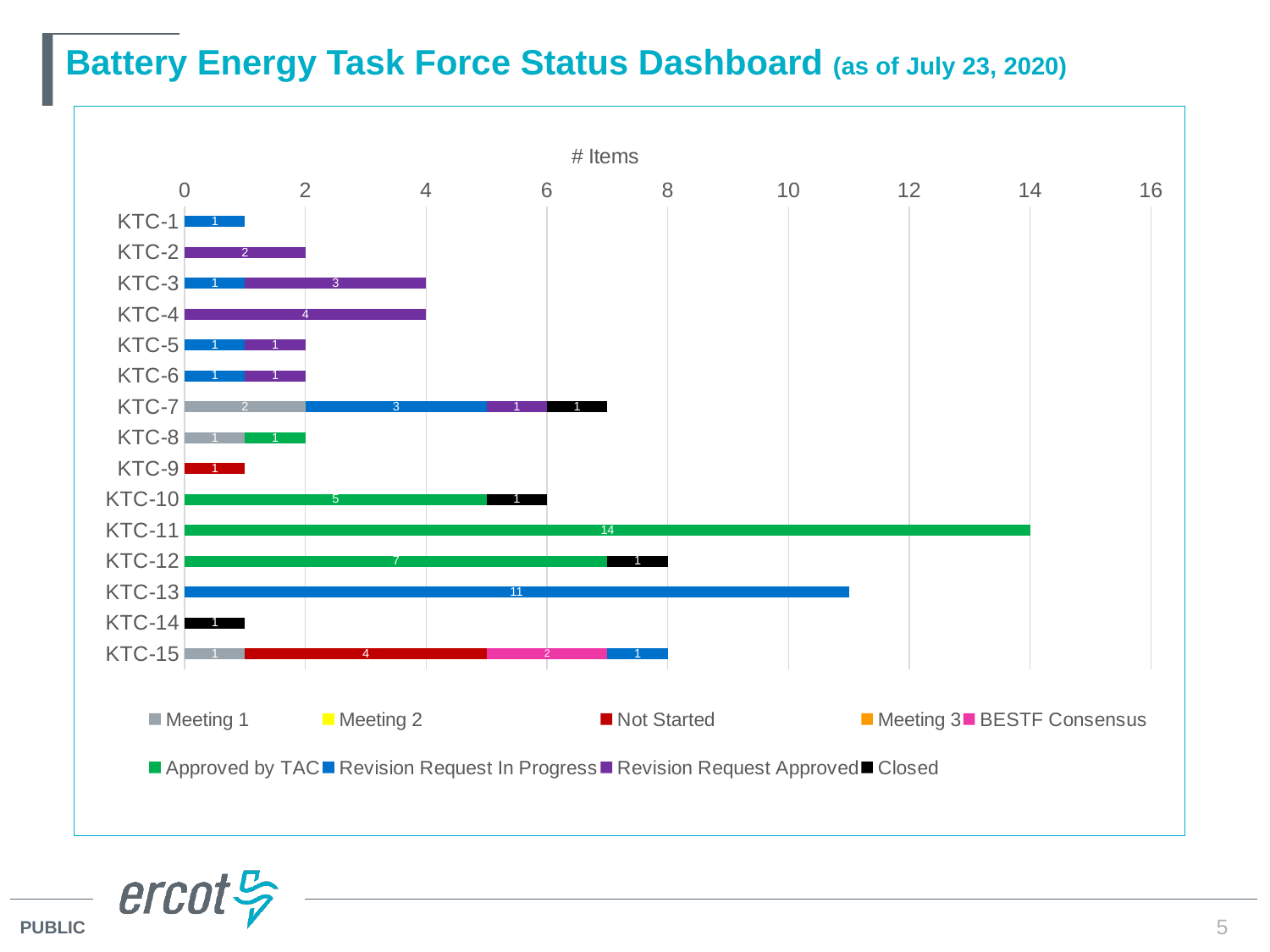
Which is larger: the Revision Request In Progress value for KTC-13 or the Approved by TAC value for KTC-10? Revision Request In Progress for KTC-13 What is the Revision Request Approved value for KTC-3? 3 What is the Revision Request In Progress value for KTC-13? 11 What is the total number of items for KTC-15? 8 What is the Not Started value for KTC-15? 4 What is the Approved by TAC value for KTC-11? 14 What is the total number of items for KTC-7? 7 Which KTC category has the longest total bar? KTC-11 What is the difference between the Approved by TAC value for KTC-11 and the Approved by TAC value for KTC-12? 7 How many series does the legend list? 9 What type of chart is shown on the slide? Stacked bar chart How many KTC categories are plotted on the chart? 15